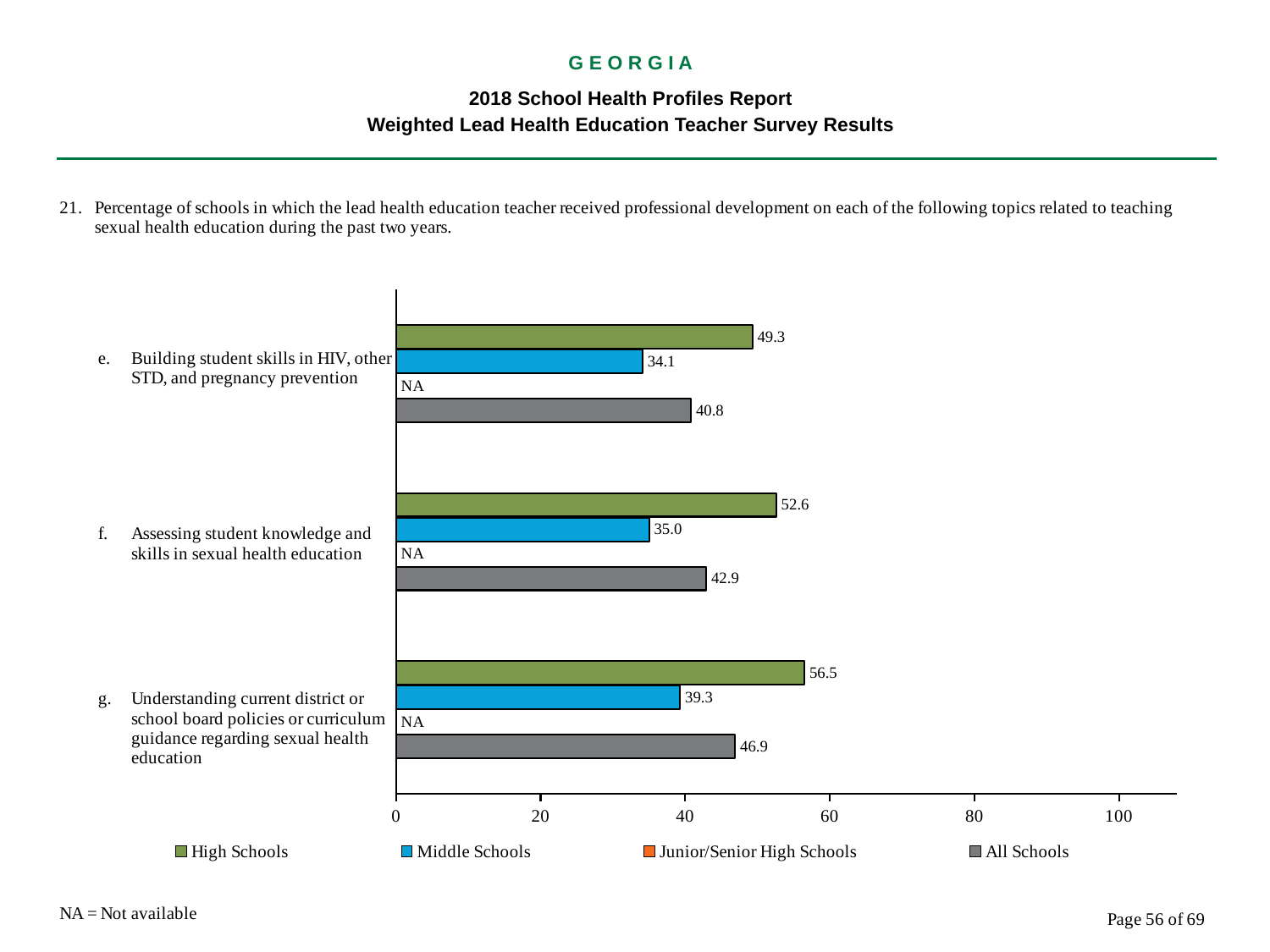
What is the Middle Schools value for 'Assessing student knowledge and skills in sexual health education'? 35.0 What is the High Schools value for 'Building student skills in HIV, other STD, and pregnancy prevention'? 49.3 What is the All Schools value for 'Understanding current district or school board policies or curriculum guidance regarding sexual health education'? 46.9 Which is larger: the All Schools value for 'Assessing student knowledge and skills in sexual health education' or the All Schools value for 'Building student skills in HIV, other STD, and pregnancy prevention'? Assessing student knowledge and skills in sexual health education How many topics (categories) are shown on the chart? 3 How many series does the legend list? 4 What kind of chart is shown on the slide? Bar chart Which topic has the lowest Middle Schools value? Building student skills in HIV, other STD, and pregnancy prevention What is the difference between the High Schools and Middle Schools values for 'Understanding current district or school board policies or curriculum guidance regarding sexual health education'? 17.2 Which topic has the highest High Schools value? Understanding current district or school board policies or curriculum guidance regarding sexual health education What value is shown for Junior/Senior High Schools for 'Assessing student knowledge and skills in sexual health education'? NA Is the High Schools value for 'Assessing student knowledge and skills in sexual health education' greater or less than 40? greater